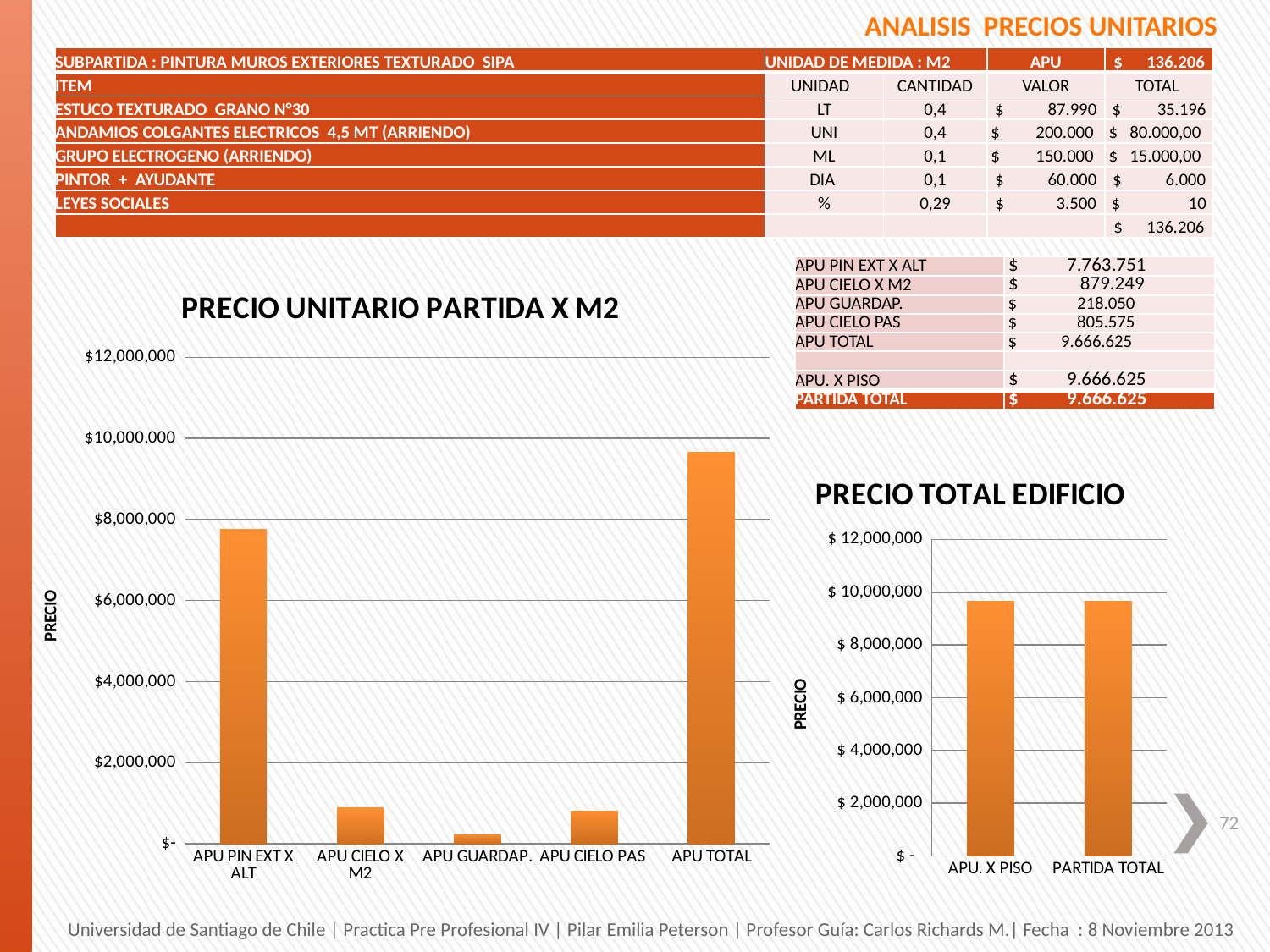
On the chart titled PRECIO TOTAL EDIFICIO, is the value for APU. X PISO greater or less than $8,000,000? greater On the chart titled PRECIO TOTAL EDIFICIO, is the value for PARTIDA TOTAL greater or less than $10,000,000? less On the chart titled PRECIO UNITARIO PARTIDA X M2, is the value for APU CIELO X M2 greater or less than $2,000,000? less On the chart titled PRECIO UNITARIO PARTIDA X M2, how many categories are plotted? 5 On the chart titled PRECIO UNITARIO PARTIDA X M2, what is the label of the vertical axis? PRECIO On the chart titled PRECIO UNITARIO PARTIDA X M2, which category has the lowest value? APU GUARDAP. On the chart titled PRECIO UNITARIO PARTIDA X M2, which category has the highest value? APU TOTAL On the chart titled PRECIO UNITARIO PARTIDA X M2, what kind of chart is shown? bar chart On the chart titled PRECIO TOTAL EDIFICIO, how many categories are plotted? 2 On the chart titled PRECIO UNITARIO PARTIDA X M2, which is larger, APU PIN EXT X ALT or APU CIELO PAS? APU PIN EXT X ALT